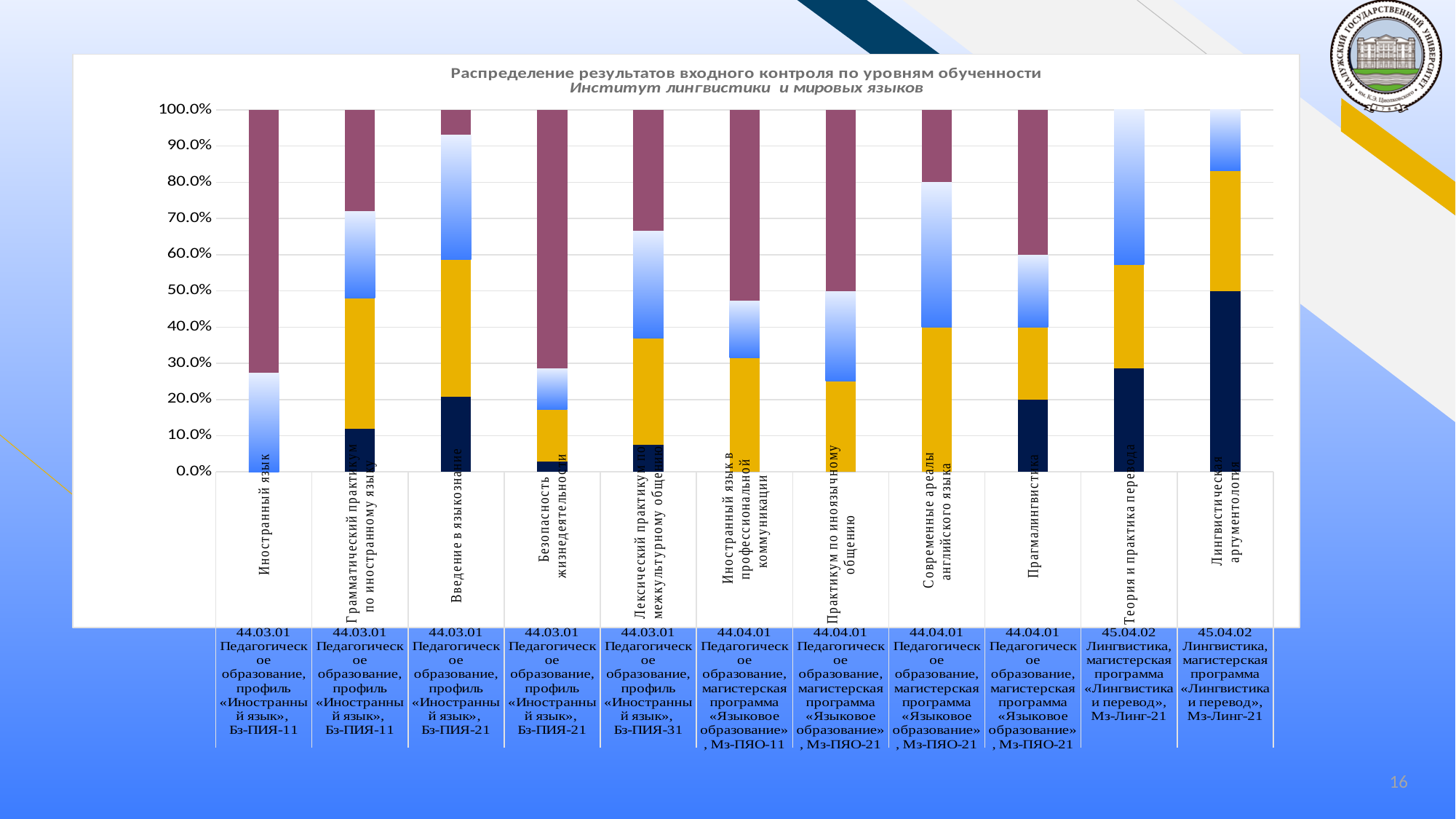
How many discipline categories (bars) are plotted in the chart? 11 Is the top of the dark navy (bottom) segment for Лингвистическая аргументология greater or less than 40%? greater Which bar has the larger purple (top) segment: Иностранный язык (Бз-ПИЯ-11) or Введение в языкознание? Иностранный язык Is the top of the yellow segment for Современные ареалы английского языка greater or less than 30%? greater Is the top of the blue segment for Практикум по иноязычному общению greater or less than 60%? less Which institute is named in the chart's subtitle? Институт лингвистики и мировых языков Which category has the largest dark navy (bottom) segment? Лингвистическая аргументология What is the title of the chart? Распределение результатов входного контроля по уровням обученности What kind of chart is shown on the slide? Stacked bar chart